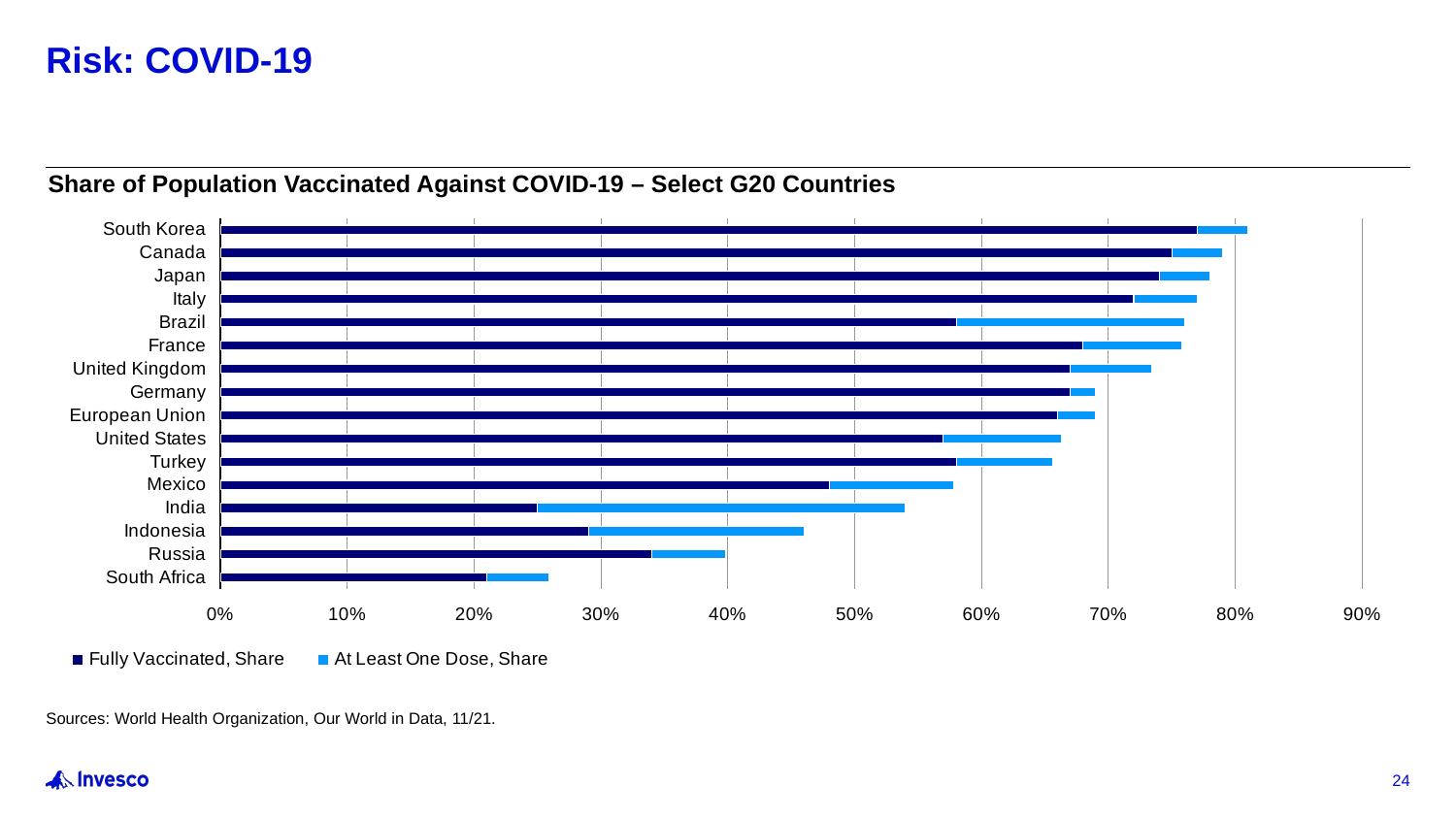
Is the at least one dose share for Brazil greater or less than 70%? greater Which country has the lowest fully vaccinated share? South Africa Which has a larger at least one dose share, India or Russia? India Is the fully vaccinated share for South Africa greater or less than 30%? less Is the at least one dose share for Russia greater or less than 50%? less Which has a larger fully vaccinated share, Brazil or Mexico? Brazil How many series does the legend list? 2 What is the title of the chart? Share of Population Vaccinated Against COVID-19 – Select G20 Countries Which country has the highest fully vaccinated share? South Korea How many countries or regions are listed on the chart? 16 What kind of chart is shown on the slide? Bar chart